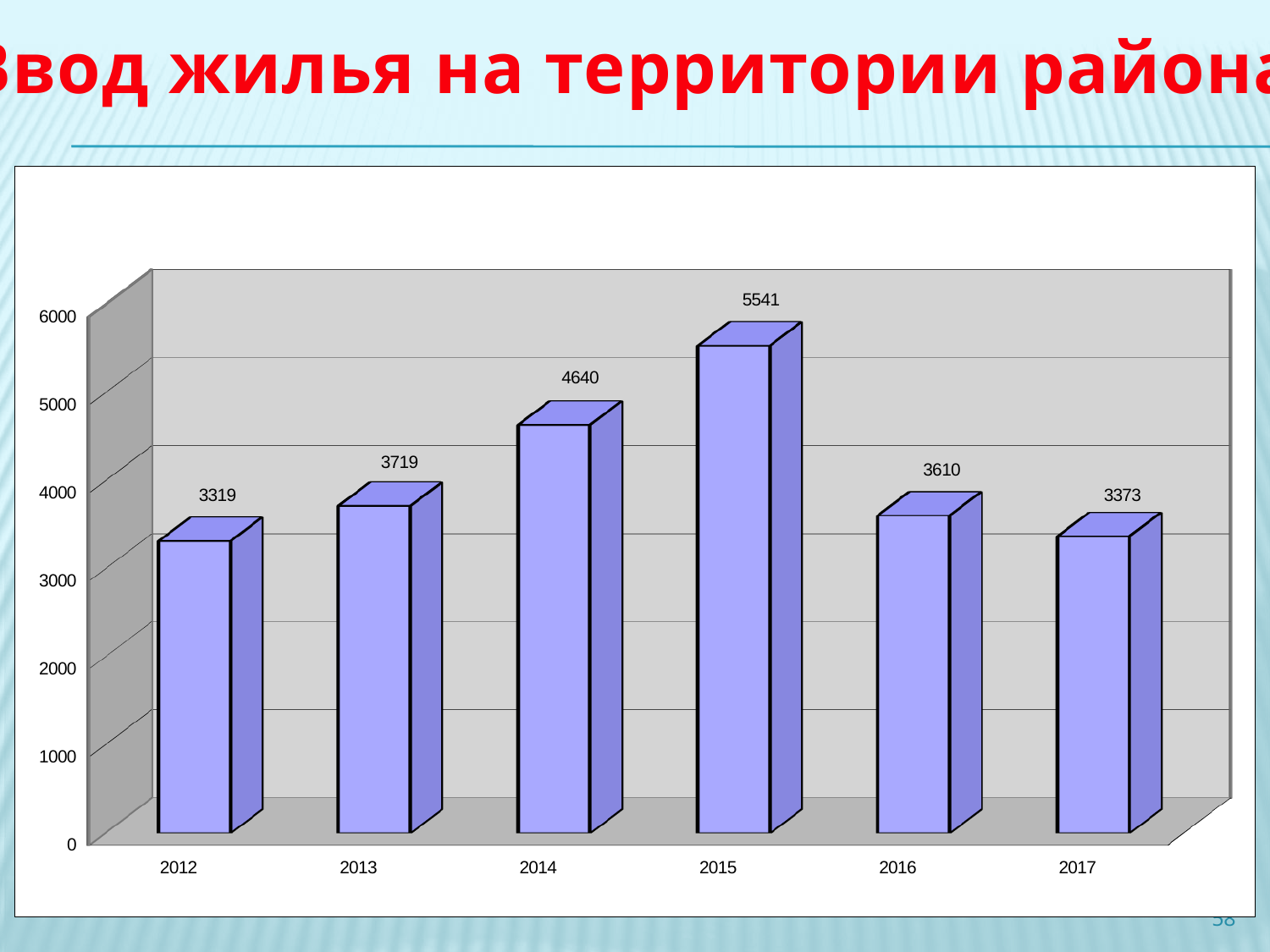
Which is larger, the value for 2016 or the value for 2017? 2016 What is the value for 2012? 3319 What is the difference between the values for 2015 and 2014? 901 What is the value for 2017? 3373 What kind of chart is shown on the slide? bar chart Which year has the lowest value? 2012 Is the value for 2014 greater or less than 4000? greater What is the difference between the values for 2013 and 2012? 400 Which year has the highest value? 2015 Do the values rise or fall from 2015 to 2017? fall What is the value for 2015? 5541 How many years are shown on the x axis? 6